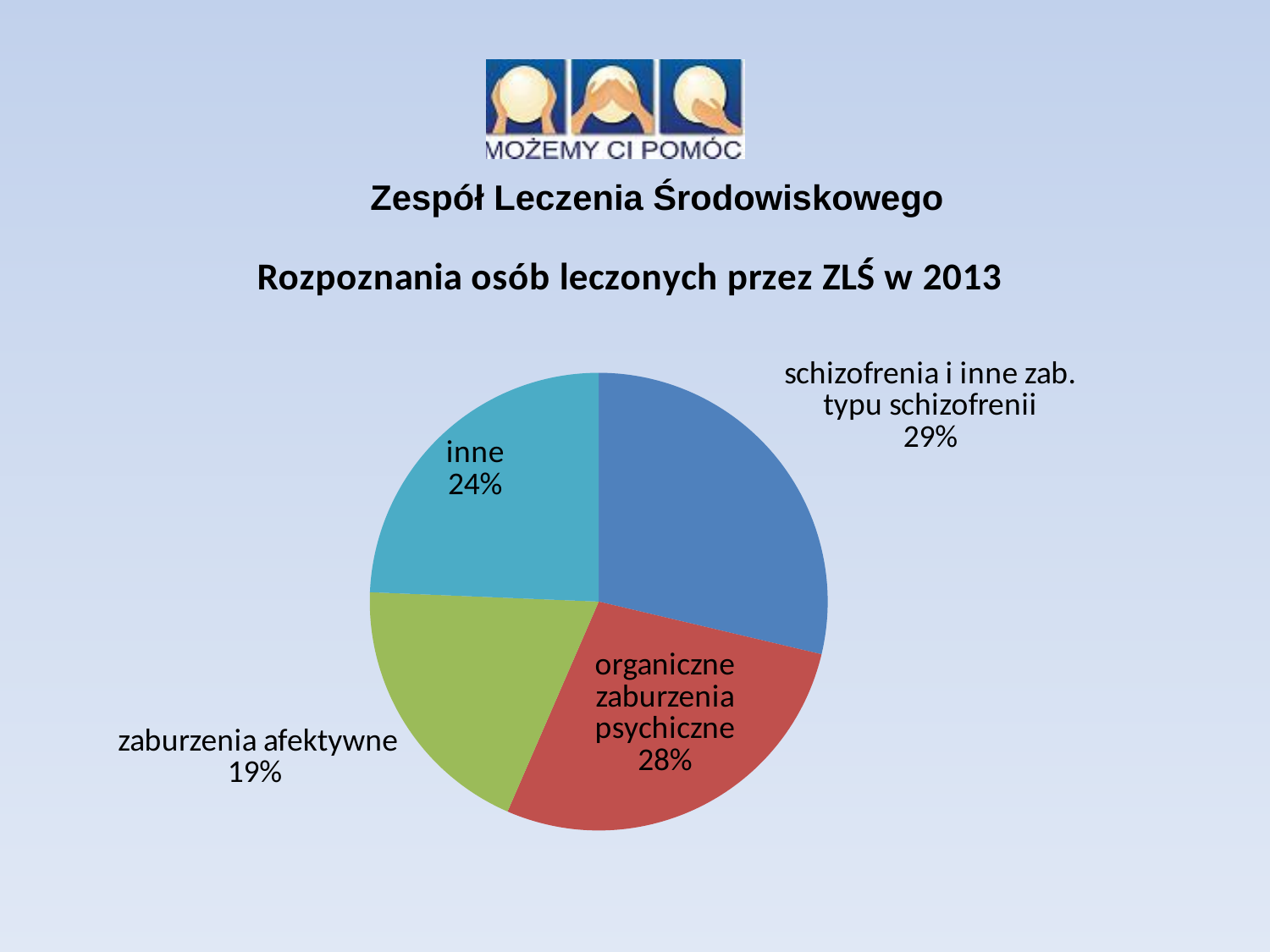
What kind of chart is shown on the slide? pie chart What is the title of the chart? Rozpoznania osób leczonych przez ZLŚ w 2013 What is the difference in percentage points between 'schizofrenia i inne zab. typu schizofrenii' and 'zaburzenia afektywne'? 10 Which category has the smallest share of the pie? zaburzenia afektywne What share of the pie is 'zaburzenia afektywne'? 19% What share of the pie is 'inne'? 24% What is the difference in percentage points between 'inne' and 'zaburzenia afektywne'? 5 What share of the pie is 'organiczne zaburzenia psychiczne'? 28% How many slices does the pie chart have? 4 Which is larger: the share for 'inne' or the share for 'zaburzenia afektywne'? inne Which category has the largest share of the pie? schizofrenia i inne zab. typu schizofrenii